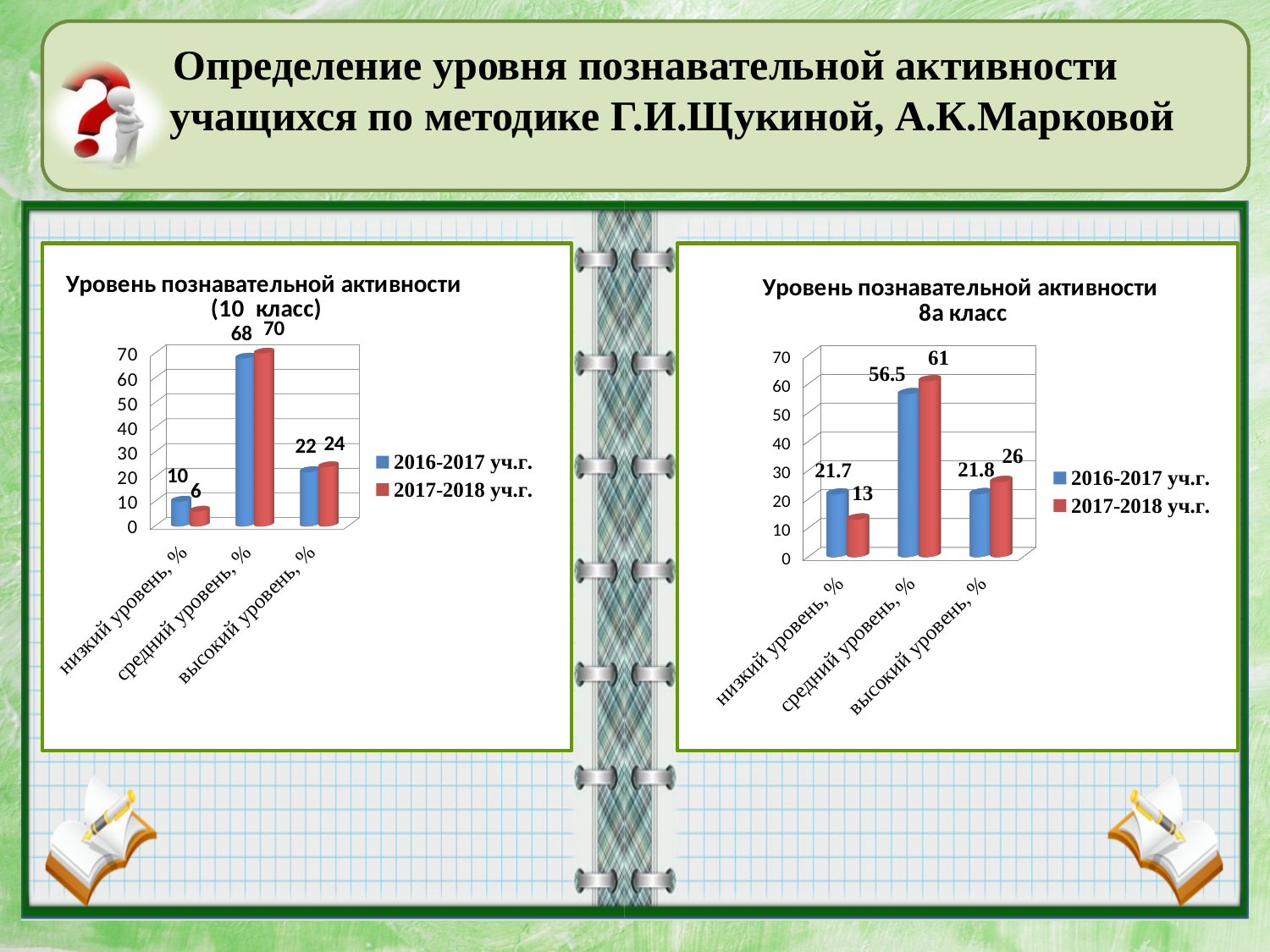
In the chart titled "Уровень познавательной активности (10 класс)", which category has the highest value in the 2017-2018 уч.г. series? средний уровень, % In the chart titled "Уровень познавательной активности 8а класс", what is the value for "средний уровень, %" in the 2017-2018 уч.г. series? 61 In the chart titled "Уровень познавательной активности 8а класс", how many categories are shown on the x axis? 3 What kind of chart is the chart titled "Уровень познавательной активности 8а класс"? bar chart In the chart titled "Уровень познавательной активности (10 класс)", how many series does the legend list? 2 In the chart titled "Уровень познавательной активности (10 класс)", what is the value for "средний уровень, %" in the 2016-2017 уч.г. series? 68 In the chart titled "Уровень познавательной активности (10 класс)", what is the difference between the 2017-2018 уч.г. and 2016-2017 уч.г. values for "высокий уровень, %"? 2 In the chart titled "Уровень познавательной активности 8а класс", what is the value for "низкий уровень, %" in the 2016-2017 уч.г. series? 21.7 In the chart titled "Уровень познавательной активности 8а класс", which category has the lowest value in the 2017-2018 уч.г. series? низкий уровень, % In the chart titled "Уровень познавательной активности (10 класс)", what is the value for "низкий уровень, %" in the 2017-2018 уч.г. series? 6 In the chart titled "Уровень познавательной активности 8а класс", what is the difference between the 2016-2017 уч.г. and 2017-2018 уч.г. values for "низкий уровень, %"? 8.7 In the chart titled "Уровень познавательной активности 8а класс", which is larger for "высокий уровень, %": the 2016-2017 уч.г. value or the 2017-2018 уч.г. value? 2017-2018 уч.г.